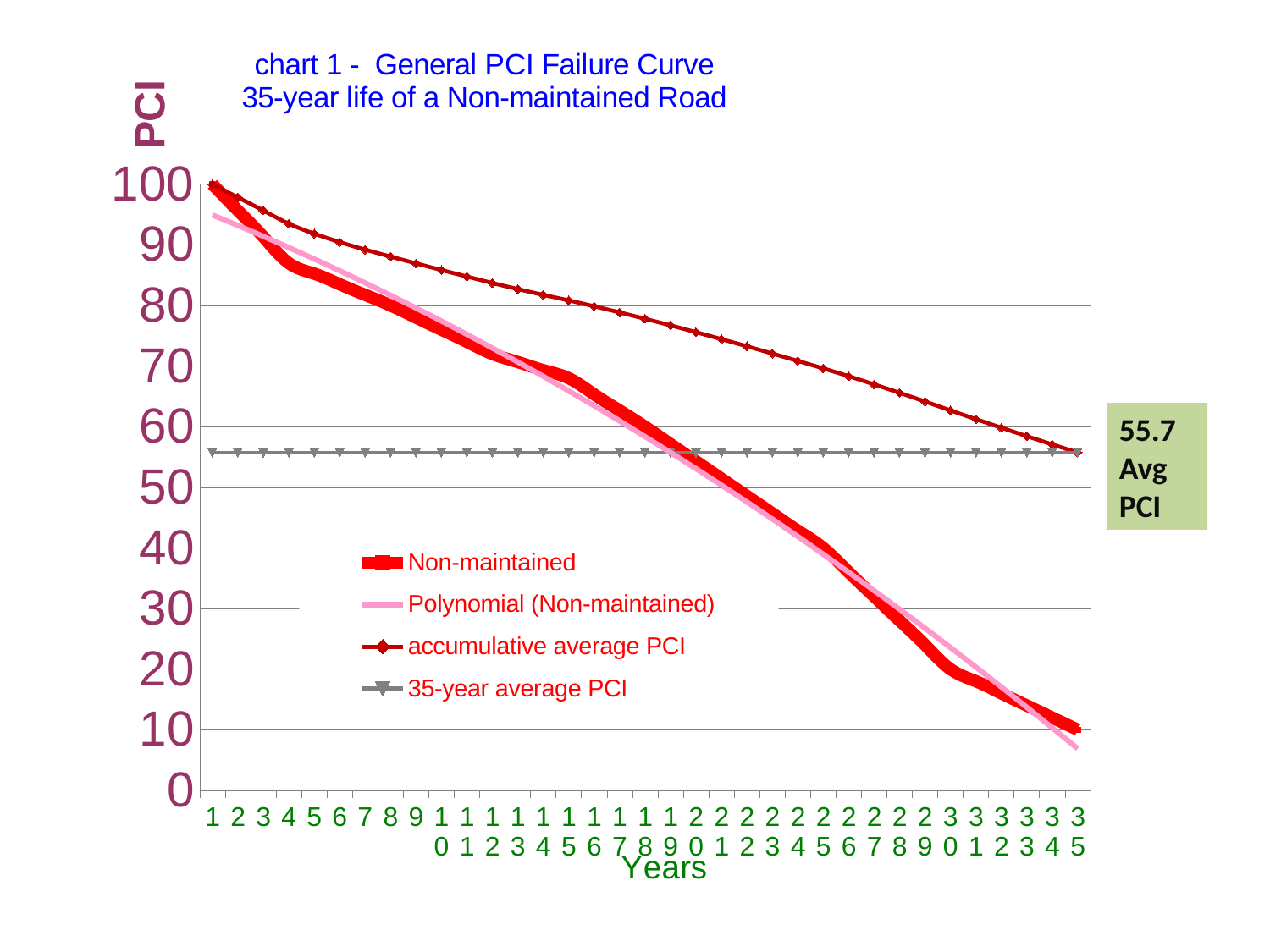
How many series does the legend list? 4 How many years are shown along the x axis? 35 What is the title of the chart? chart 1 - General PCI Failure Curve 35-year life of a Non-maintained Road Is the Non-maintained value at year 35 greater or less than 20? less Is the Non-maintained value at year 10 greater or less than 70? greater At year 30, which is larger: the accumulative average PCI or the Non-maintained value? accumulative average PCI What is the label of the x axis? Years Does the Non-maintained series rise or fall as the years increase? fall What kind of chart is shown on the slide? line chart Is the accumulative average PCI value at year 35 greater or less than 50? greater What is the 35-year average PCI value shown on the slide? 55.7 In which year is the Non-maintained series at its highest? 1